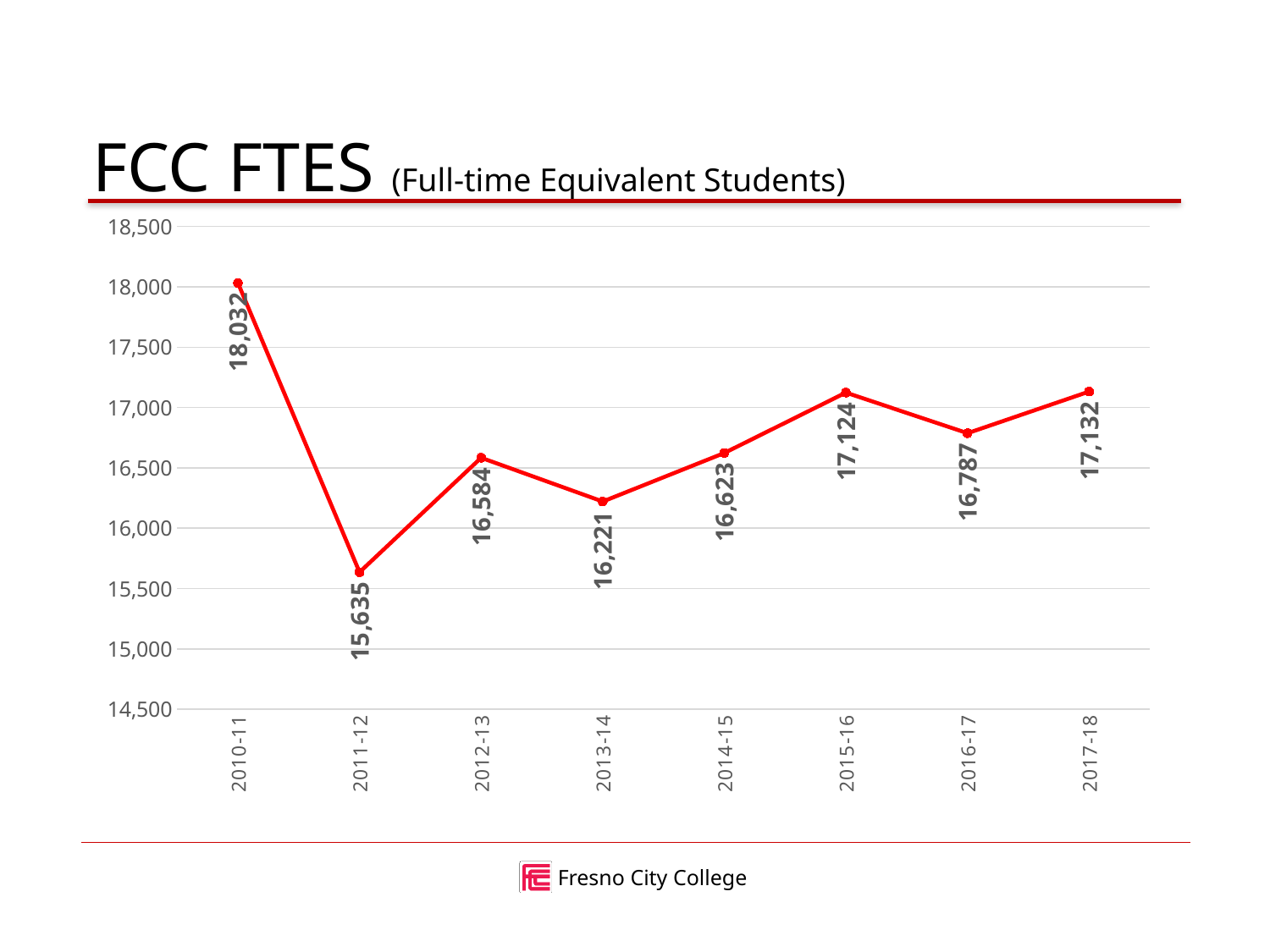
What is the FTES value for 2013-14? 16,221 Does the FTES value rise or fall from 2013-14 to 2015-16? rise What is the FTES value for 2010-11? 18,032 What is the difference between the FTES values for 2015-16 and 2016-17? 337 What is the FTES value for 2016-17? 16,787 Is the FTES value for 2011-12 greater or less than 16,000? less Which year has the highest FTES value? 2010-11 Which is larger, the FTES value for 2012-13 or for 2014-15? 2014-15 What is the difference between the FTES values for 2010-11 and 2011-12? 2,397 Which year has the lowest FTES value? 2011-12 How many academic years are plotted on the chart? 8 What kind of chart is shown on the slide? line chart